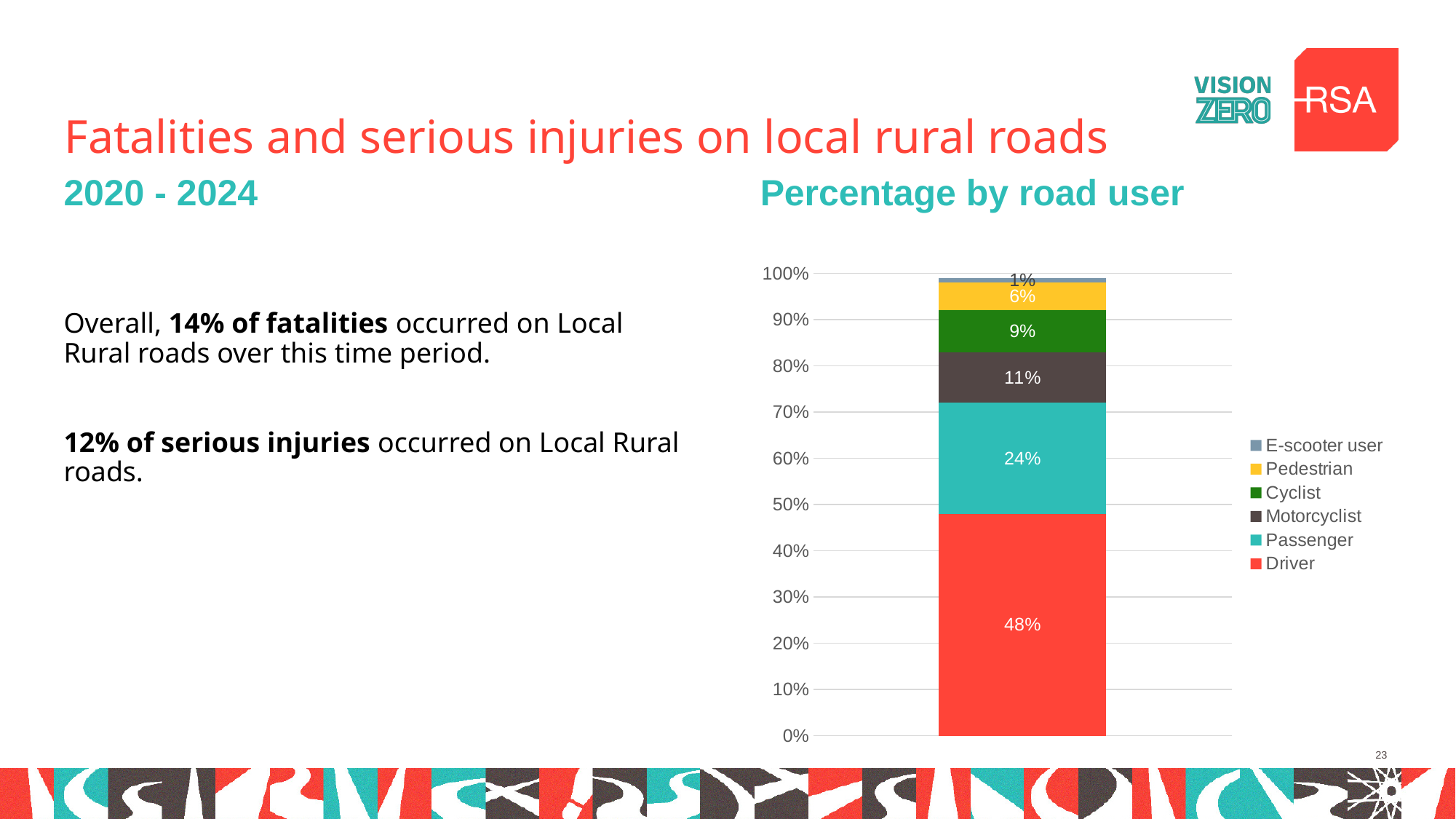
What is the difference between the Driver and Passenger percentages? 24% Which road user category has the smallest share of the bar? E-scooter user Which is larger, the Motorcyclist share or the Cyclist share? Motorcyclist Which road user category has the largest share of the bar? Driver What kind of chart is shown on the slide? Stacked bar chart What percentage of the stacked bar is attributed to Driver? 48% What is the value shown for Motorcyclist? 11% What percentage does the Passenger segment show? 24% How many road user categories does the legend list? 6 What is the title shown above the chart? Percentage by road user What percentage is shown for Pedestrian? 6% What is the value shown for Cyclist? 9%